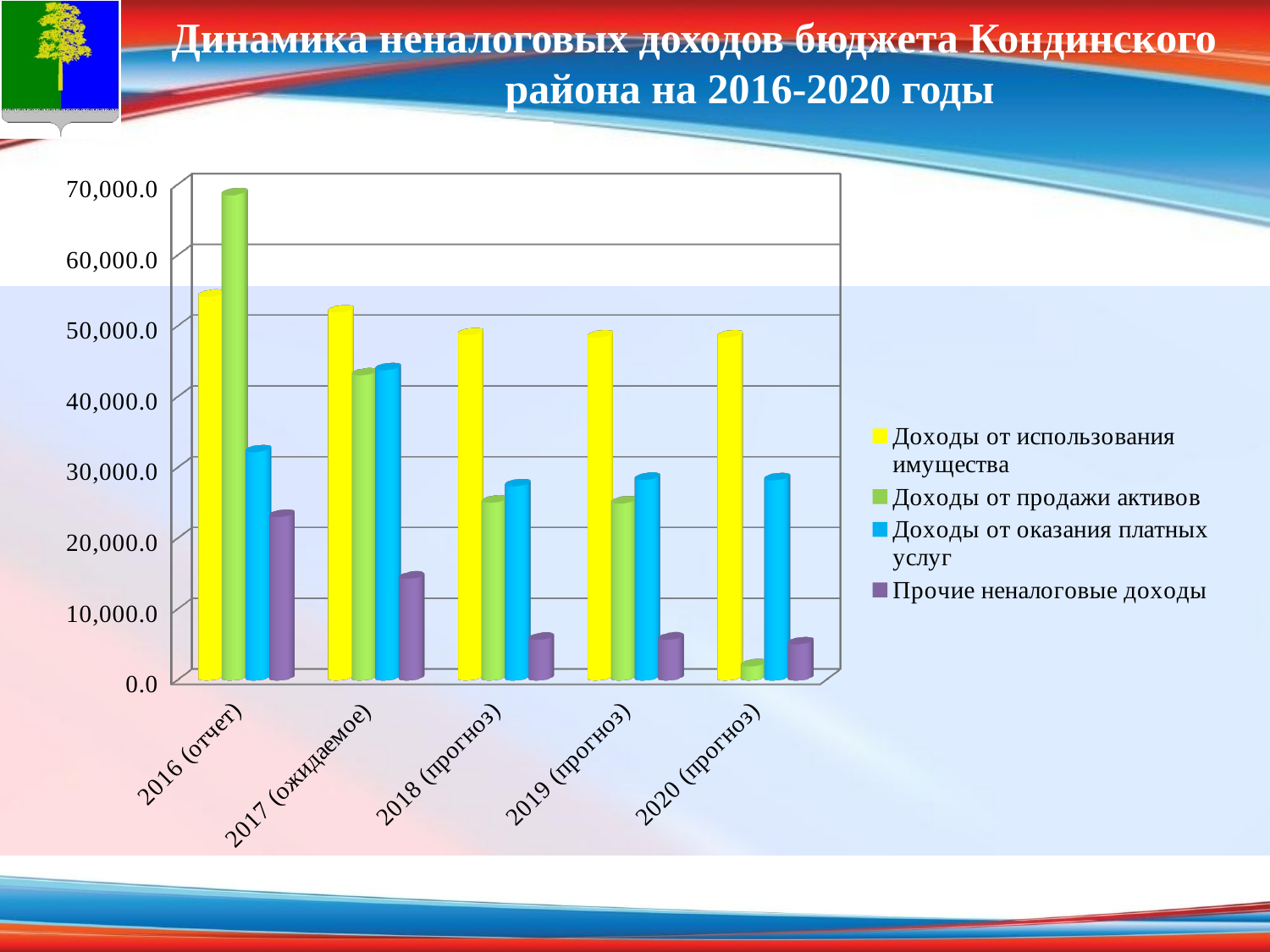
Is the value for Доходы от использования имущества in 2016 (отчет) greater or less than 50,000.0? greater What kind of chart is shown on the slide? bar chart In which year is the value for Доходы от продажи активов the highest? 2016 (отчет) Is the value for Прочие неналоговые доходы in 2017 (ожидаемое) greater or less than 20,000.0? less Is the value for Доходы от продажи активов in 2020 (прогноз) greater or less than 10,000.0? less How many series does the legend list? 4 Does the value for Доходы от использования имущества rise or fall from 2016 (отчет) to 2018 (прогноз)? fall How many year categories are shown on the x axis? 5 In which year is the value for Доходы от продажи активов the lowest? 2020 (прогноз) In 2016 (отчет), which is larger: Доходы от продажи активов or Доходы от использования имущества? Доходы от продажи активов Which series has the highest value in 2016 (отчет)? Доходы от продажи активов